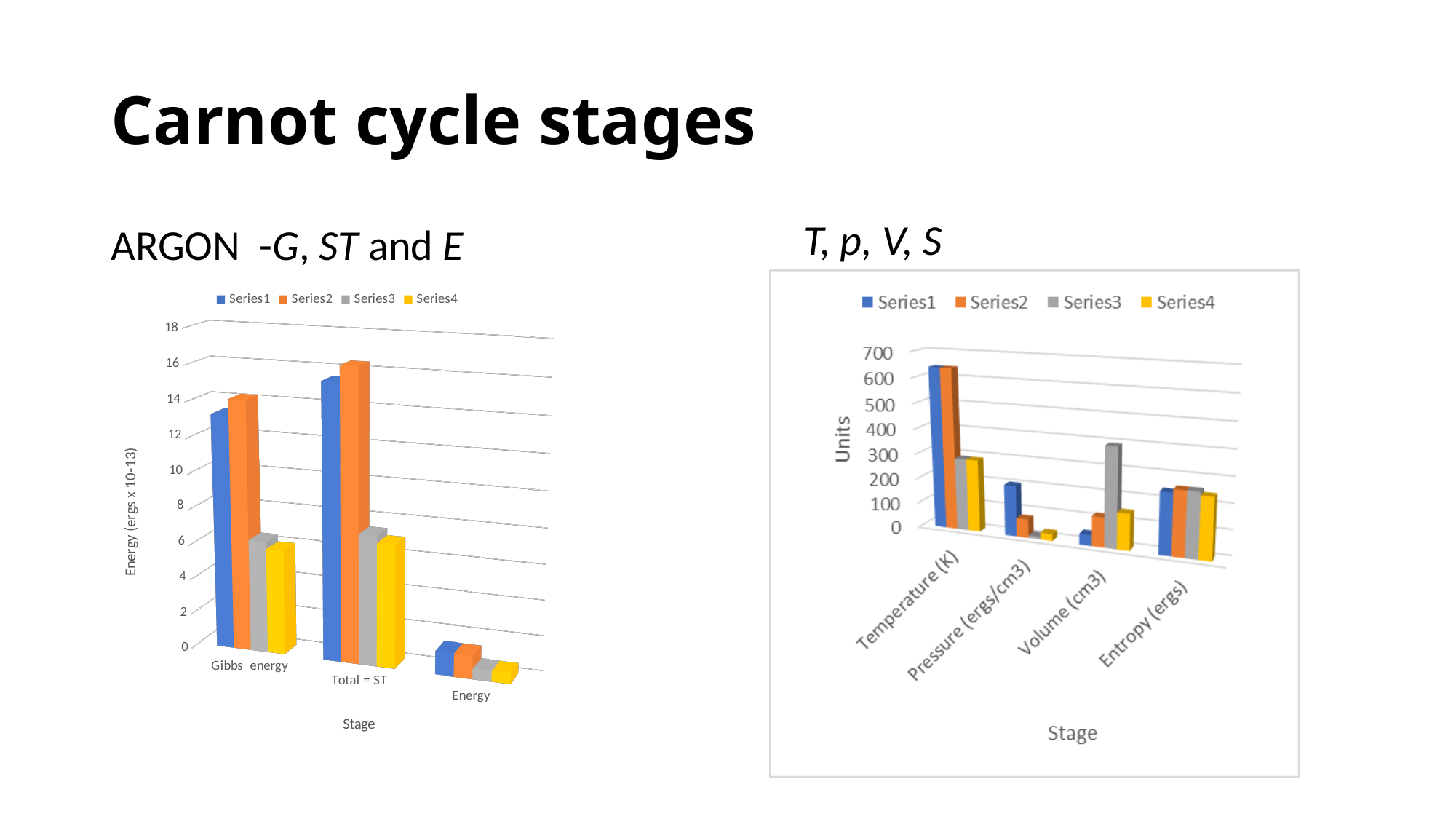
What kind of chart is the left chart titled "ARGON -G, ST and E"? bar chart In the right chart (T, p, V, S), which category has the highest Series3 bar? Volume (cm3) In the left chart (ARGON -G, ST and E), which category has the lowest Series1 bar? Energy In the left chart (ARGON -G, ST and E), is the Series2 value for Total = ST greater or less than 10? greater In the left chart (ARGON -G, ST and E), for Gibbs energy, which is larger: Series2 or Series3? Series2 In the right chart (T, p, V, S), how many categories are shown on the x axis? 4 In the left chart (ARGON -G, ST and E), which category has the highest Series2 bar? Total = ST In the right chart (T, p, V, S), is the Series1 value for Temperature (K) greater or less than 500? greater In the left chart (ARGON -G, ST and E), how many series does the legend list? 4 In the right chart (T, p, V, S), what is the title of the vertical axis? Units In the left chart (ARGON -G, ST and E), is the Series1 value for Energy greater or less than 4? less In the left chart (ARGON -G, ST and E), how many categories are shown on the x axis? 3